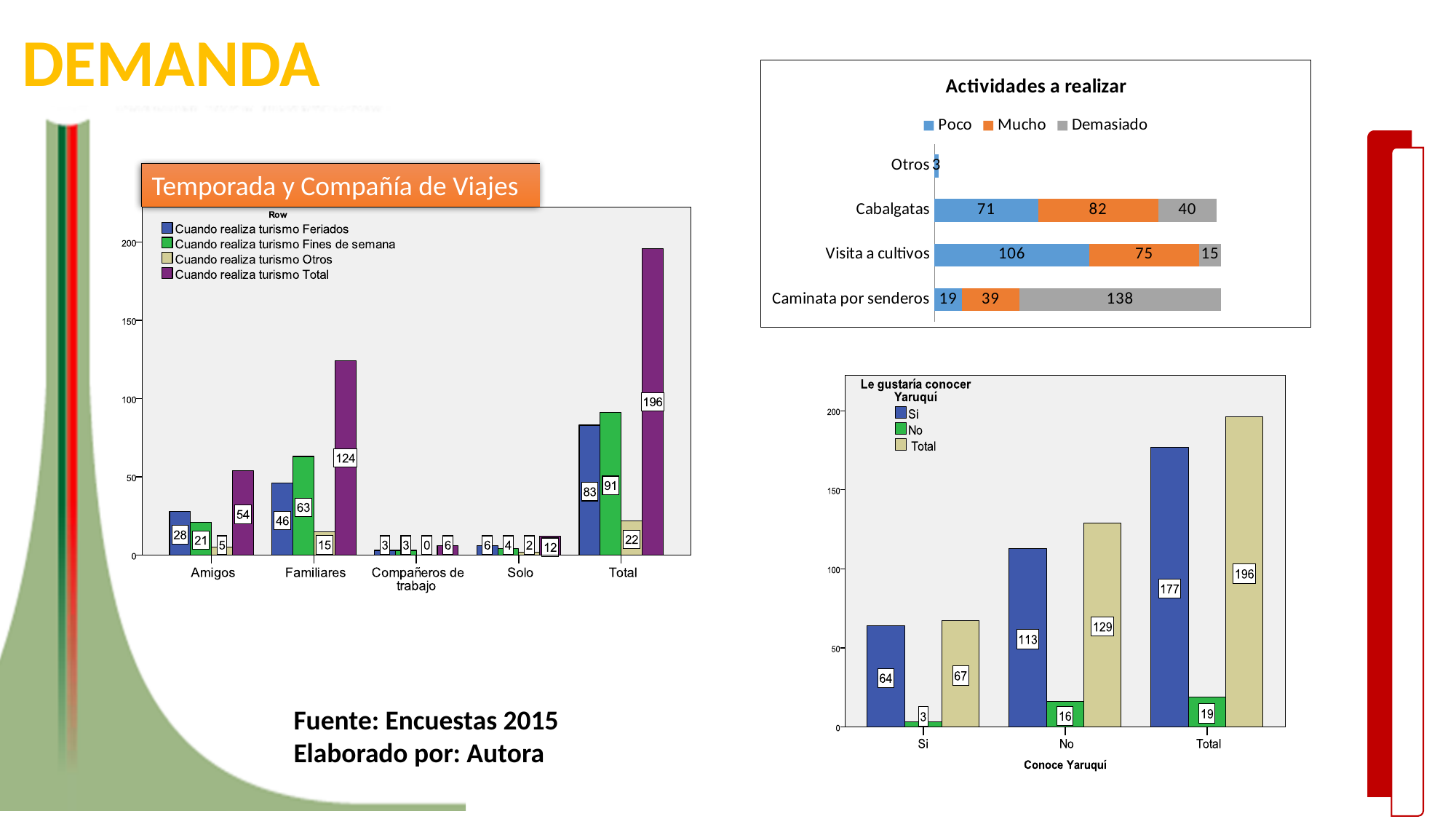
In the 'Temporada y Compañía de Viajes' chart, how many categories are shown on the x axis? 5 In the 'Temporada y Compañía de Viajes' chart, what is the value for 'Cuando realiza turismo Fines de semana' in the Familiares category? 63 In the 'Actividades a realizar' chart, what is the total of the stacked bar for Cabalgatas? 193 In the 'Actividades a realizar' chart, which activity has the highest 'Poco' value? Visita a cultivos In the 'Actividades a realizar' chart, what is the 'Demasiado' value for Caminata por senderos? 138 In the bottom-right chart with x axis 'Conoce Yaruquí', what is the 'Si' value for the No category? 113 In the 'Temporada y Compañía de Viajes' chart, which category has the lowest 'Cuando realiza turismo Total' value? Compañeros de trabajo In the 'Temporada y Compañía de Viajes' chart, is the 'Cuando realiza turismo Feriados' value for Amigos larger or smaller than the 'Cuando realiza turismo Fines de semana' value for Amigos? larger What kind of chart is the bottom-right chart with x axis 'Conoce Yaruquí'? bar chart In the 'Actividades a realizar' chart, what is the difference between the 'Mucho' values for Cabalgatas and Visita a cultivos? 7 In the 'Actividades a realizar' chart, how many series does the legend list? 3 In the bottom-right chart with x axis 'Conoce Yaruquí', what is the difference between the 'Total' values for No and Si? 62